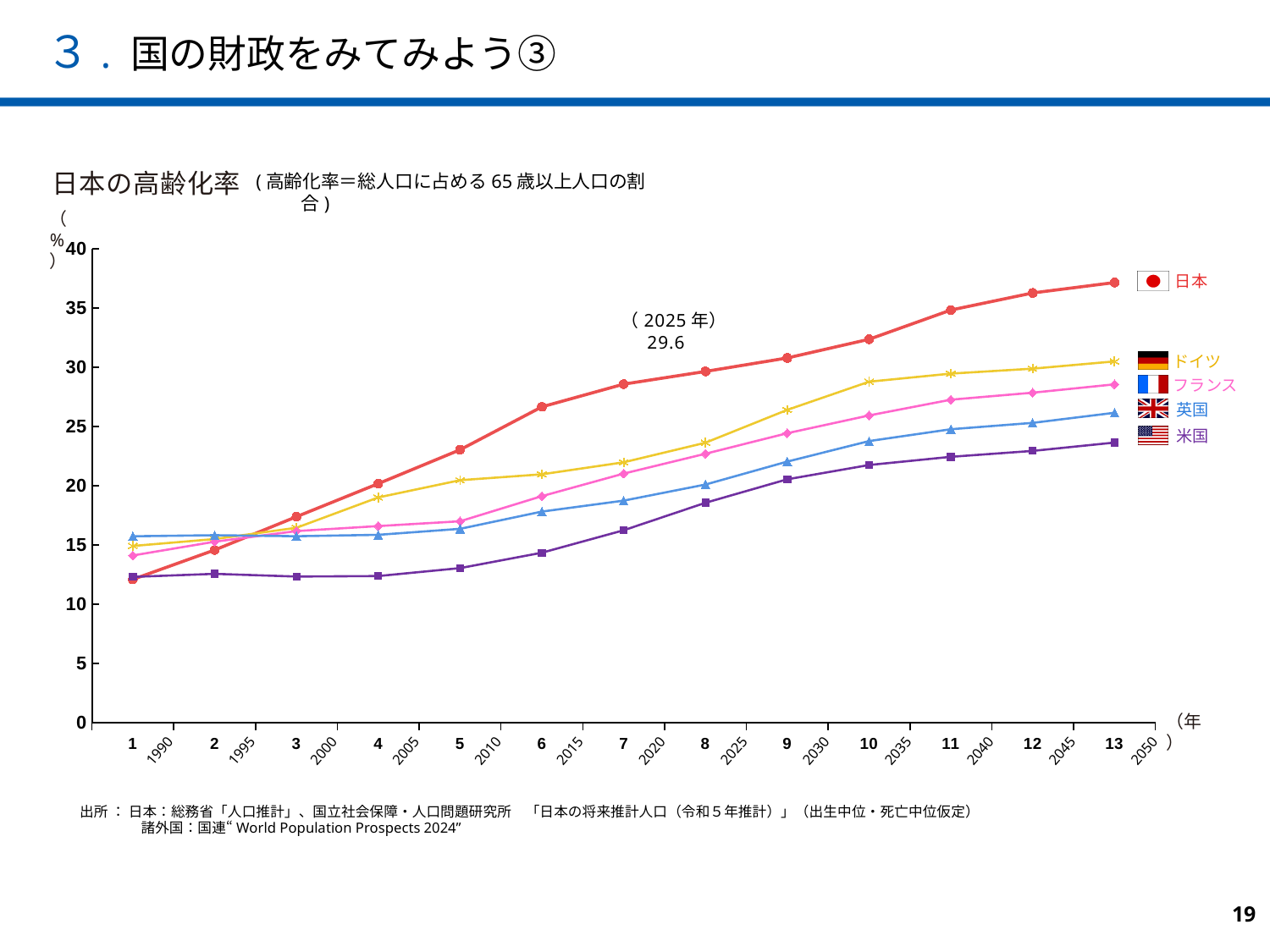
Is the value for 日本 in 2050 greater or less than 35? greater What is the value for 日本 in 2025? 29.6 In 2050, which is larger, the value for ドイツ or the value for フランス? ドイツ Is the value for 米国 in 1990 greater or less than 15? less How many series does the legend list? 5 How many data points does each line have? 13 What kind of chart is shown on the slide? line chart Which country has the highest value in 2050? 日本 What is the title of the chart? 日本の高齢化率 Does the line for 日本 rise or fall from 1990 to 2050? rise Is the value for 英国 in 2050 greater or less than 30? less Which country has the lowest value in 2050? 米国